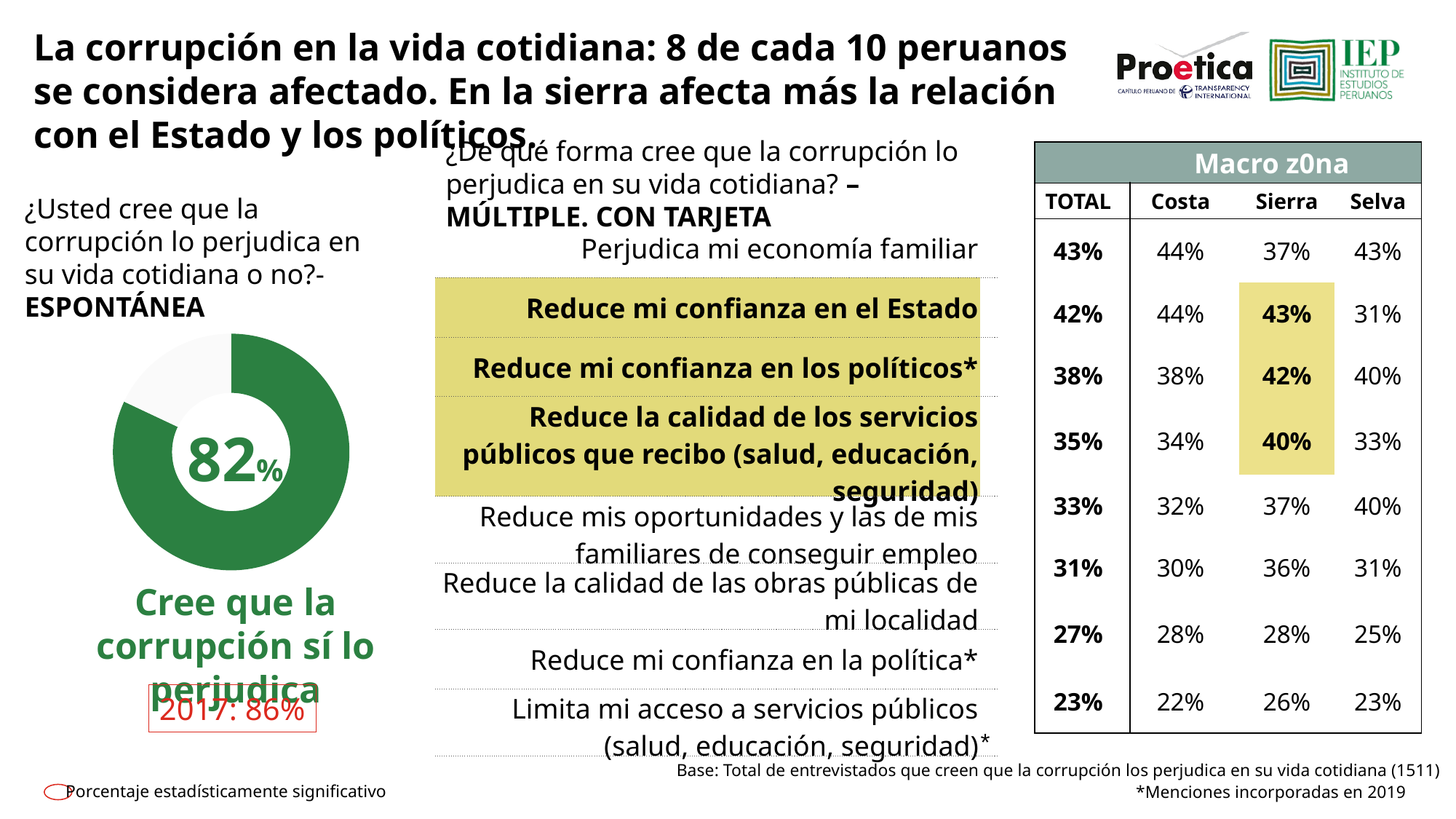
What colour is the filled segment of the donut chart? Green What kind of chart is shown on the left of the slide? Donut (pie) chart Which is larger: the 2017 value (86%) or the current value shown in the donut chart? 2017: 86% What label appears in green below the donut chart? Cree que la corrupción sí lo perjudica Is the value shown in the donut chart greater or less than 50%? greater By how many percentage points did the value in the donut chart change from 2017 (86%) to the current 82%? 4 percentage points lower What percentage is shown in the centre of the donut chart? 82% What share of respondents believe corruption does harm them in their daily life, according to the donut chart? 82% How many segments does the donut chart have? 2 What was the 2017 value noted below the donut chart? 86%